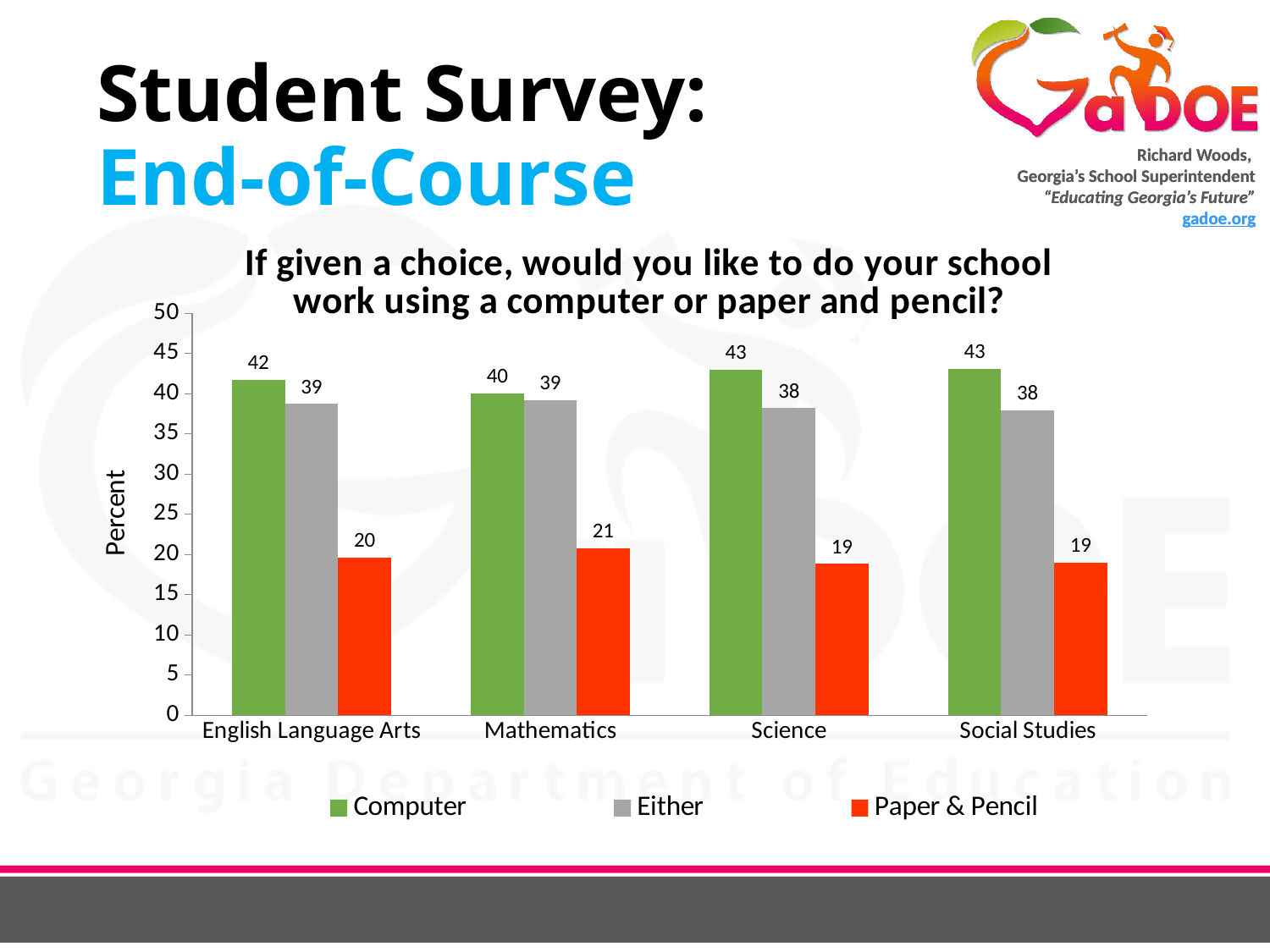
What kind of chart is shown? bar chart What is the value for Computer in Science? 43 What is the value for Either in English Language Arts? 39 Is the value for Paper & Pencil in English Language Arts greater or less than 25? less Which series has the lowest value in Social Studies? Paper & Pencil What is the label on the vertical axis? Percent What is the difference between the Computer and Paper & Pencil values in Science? 24 Which is larger in Mathematics, Computer or Either? Computer How many series does the legend list? 3 How many subject categories are shown on the x axis? 4 What is the value for Paper & Pencil in Mathematics? 21 Which subject has the lowest value for Computer? Mathematics